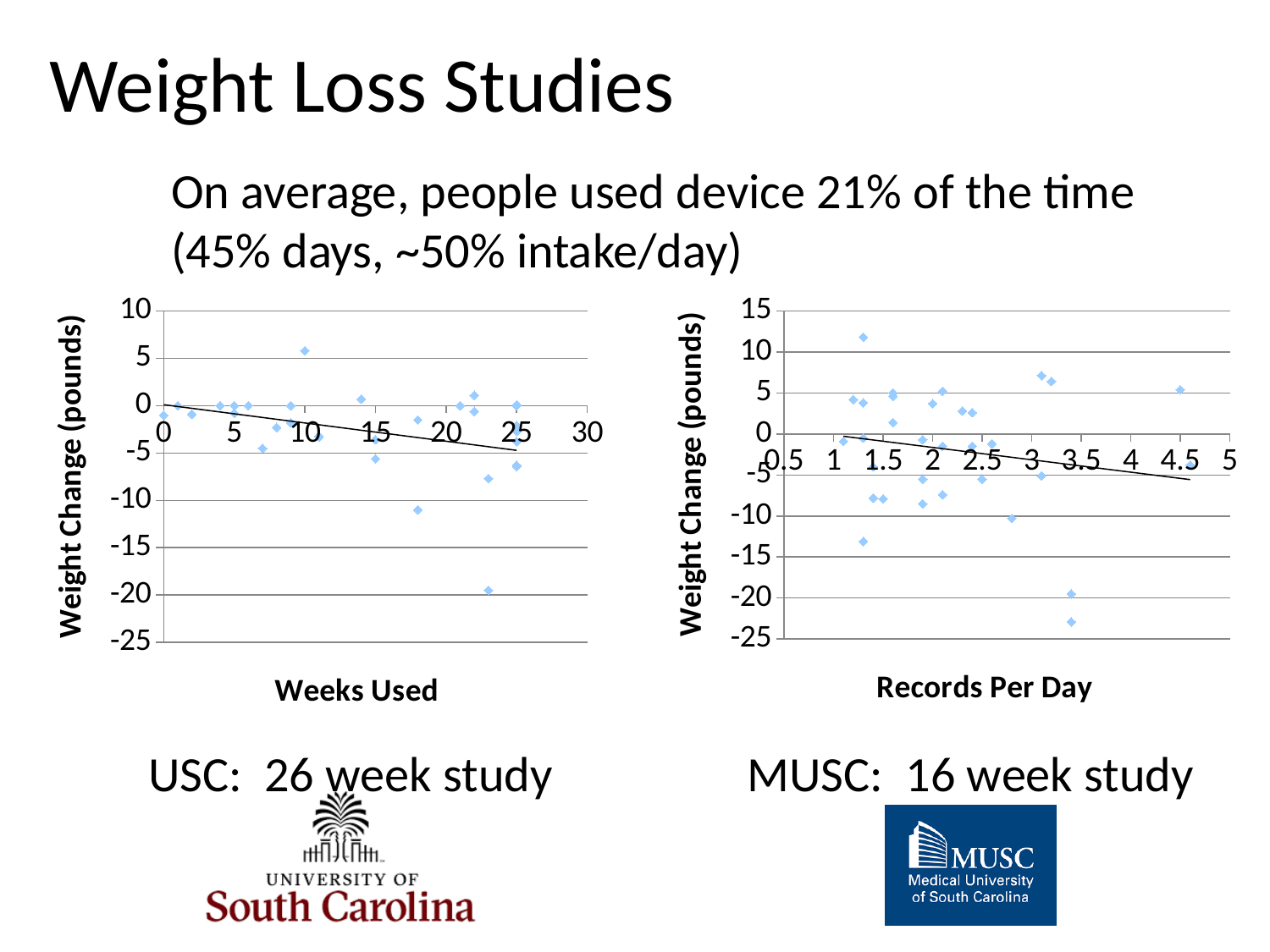
In the left chart (Weeks Used), is the highest plotted weight change greater or less than 0? greater In the right chart (Records Per Day), is the lowest plotted weight change greater or less than -20? less In the right chart (Records Per Day), is the highest plotted weight change greater or less than 10? greater What kind of chart is the right chart, with x axis 'Records Per Day'? scatter chart In the right chart (Records Per Day), what is the maximum value shown on the y axis? 15 In the left chart (Weeks Used), does the fitted trend line rise or fall as weeks used increases? fall What is the x-axis title of the right chart? Records Per Day What is the y-axis title of the left chart? Weight Change (pounds) In the left chart (Weeks Used), what is the maximum value shown on the x axis? 30 What kind of chart is the left chart, titled with x axis 'Weeks Used'? scatter chart In the right chart (Records Per Day), does the fitted trend line rise or fall as records per day increases? fall